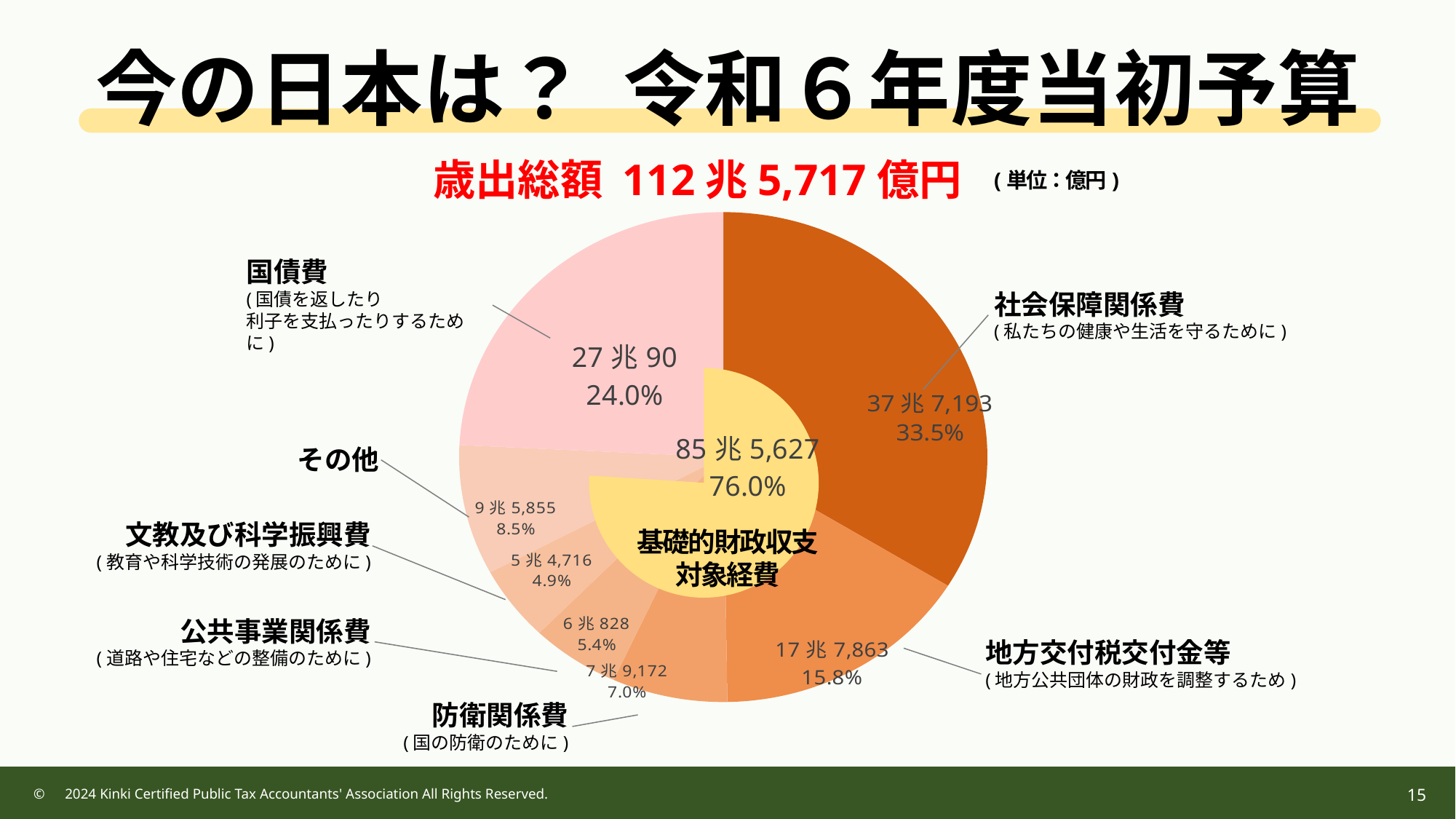
Which category has the smallest share of the pie? 文教及び科学振興費 What is the difference in percentage points between the share of 社会保障関係費 and the share of 国債費? 9.5% What percentage share does その他 have? 8.5% What percentage share does 文教及び科学振興費 have? 4.9% What kind of chart is shown on the slide? Pie chart What is the value shown for 国債費? 27兆90 What is the total expenditure amount (歳出総額) shown above the chart? 112兆5,717億円 What is the value shown for 地方交付税交付金等? 17兆7,863 What is the value shown for 社会保障関係費? 37兆7,193 Which category has the largest share of the pie? 社会保障関係費 What is the value shown for 防衛関係費? 7兆9,172 Which is larger, the share of 公共事業関係費 or the share of 防衛関係費? 防衛関係費